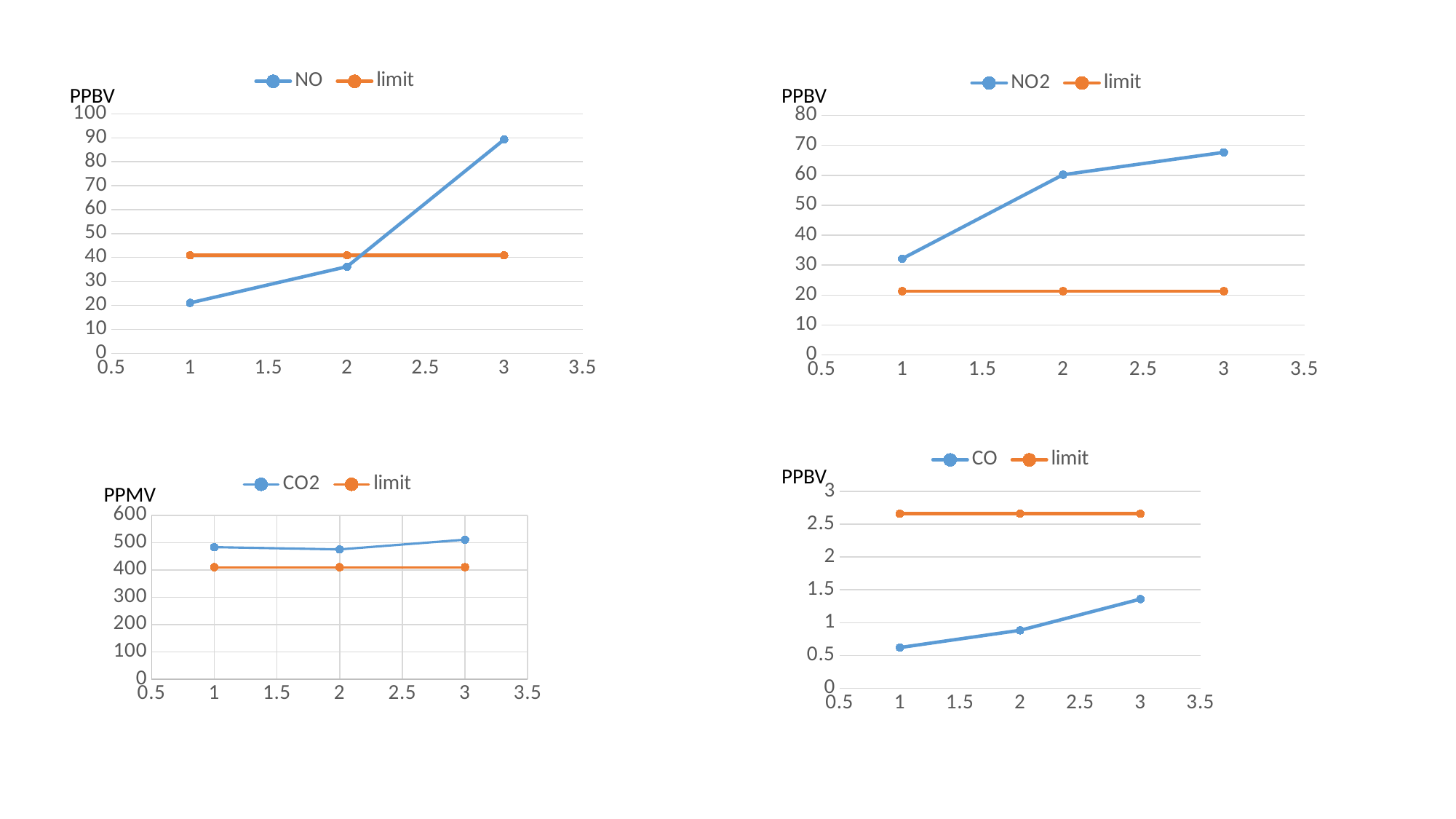
In the bottom-left chart, is the limit value greater or less than 500? less How many series does the legend of the top-right chart (NO2) list? 2 In the bottom-right chart, which is larger at x = 3: the CO value or the limit value? limit In the top-left chart, is the NO value at x = 1 greater or less than 30? less How many data points does the NO series have in the top-left chart? 3 In the bottom-left chart, at which x value is the CO2 series lowest? 2 What is the y-axis unit label shown on the bottom-left chart (CO2)? PPMV What kind of chart is the top-left chart (NO)? line chart In the top-left chart, does the NO series rise or fall from x = 1 to x = 3? rise In the top-right chart, is the NO2 value at x = 1 greater or less than 40? less In the top-right chart, which is larger at x = 2: the NO2 value or the limit value? NO2